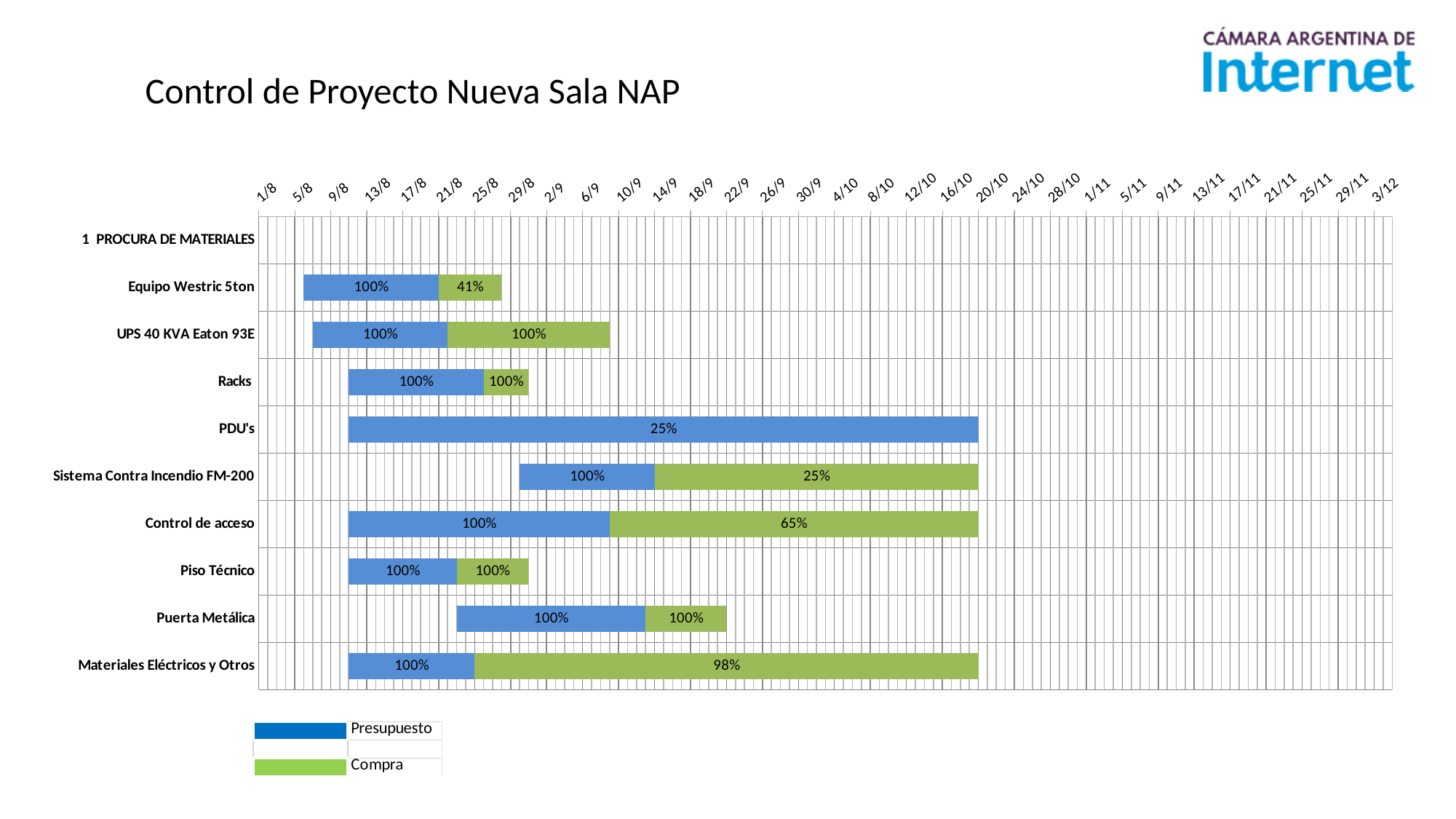
What are the two legend entries of the chart? Presupuesto and Compra What percentage is shown on the Presupuesto bar for PDU's? 25% What is the difference between the Compra percentage for Materiales Eléctricos y Otros and for Control de acceso? 33% Which task has the lowest Compra percentage label? Sistema Contra Incendio FM-200 How many series does the legend list? 2 What is the Compra percentage for Materiales Eléctricos y Otros? 98% What is the Compra percentage for Sistema Contra Incendio FM-200? 25% Which is larger, the Compra percentage for Control de acceso or for Equipo Westric 5ton? Control de acceso How many tasks have bars plotted on the chart? 9 What is the Compra percentage shown for Equipo Westric 5ton? 41% What is the Compra percentage for Control de acceso? 65% Which task has the lowest Presupuesto percentage label? PDU's